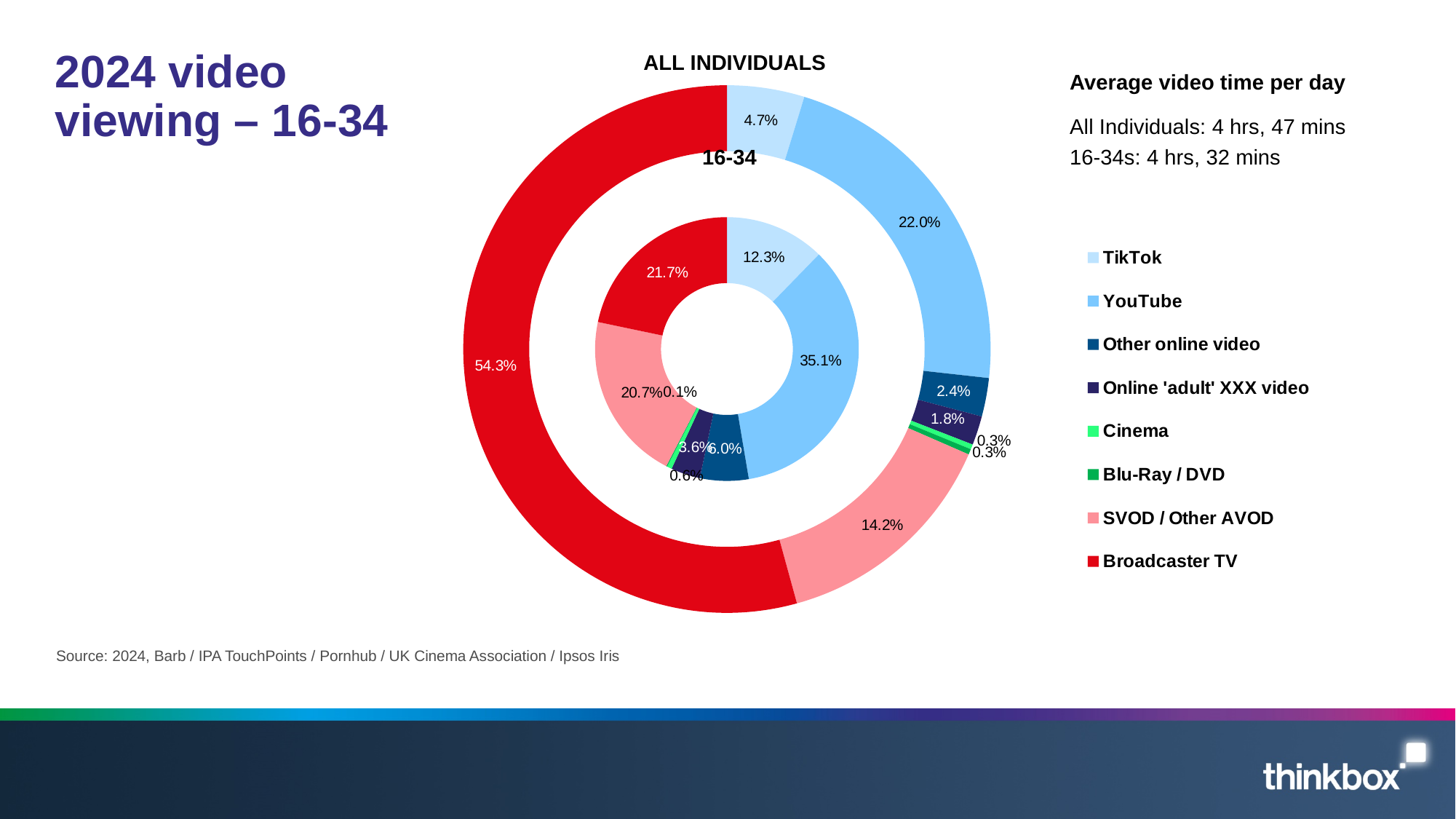
In the inner ring (16-34), what share does YouTube have? 35.1% Which category has the largest share in the inner ring (16-34)? YouTube Which category has the largest share in the outer ring (ALL INDIVIDUALS)? Broadcaster TV In the inner ring (16-34), what share does TikTok have? 12.3% In the inner ring (16-34), which is larger: Broadcaster TV or SVOD / Other AVOD? Broadcaster TV In the outer ring (ALL INDIVIDUALS), what share does Broadcaster TV have? 54.3% How many categories does the legend list? 8 What is the difference between the YouTube share for 16-34 (35.1%) and for ALL INDIVIDUALS (22.0%)? 13.1% What kind of chart is shown on the slide? doughnut chart What colour represents Broadcaster TV in the chart? red What is the difference between the Broadcaster TV share for ALL INDIVIDUALS (54.3%) and for 16-34 (21.7%)? 32.6% In the outer ring (ALL INDIVIDUALS), what share does SVOD / Other AVOD have? 14.2%